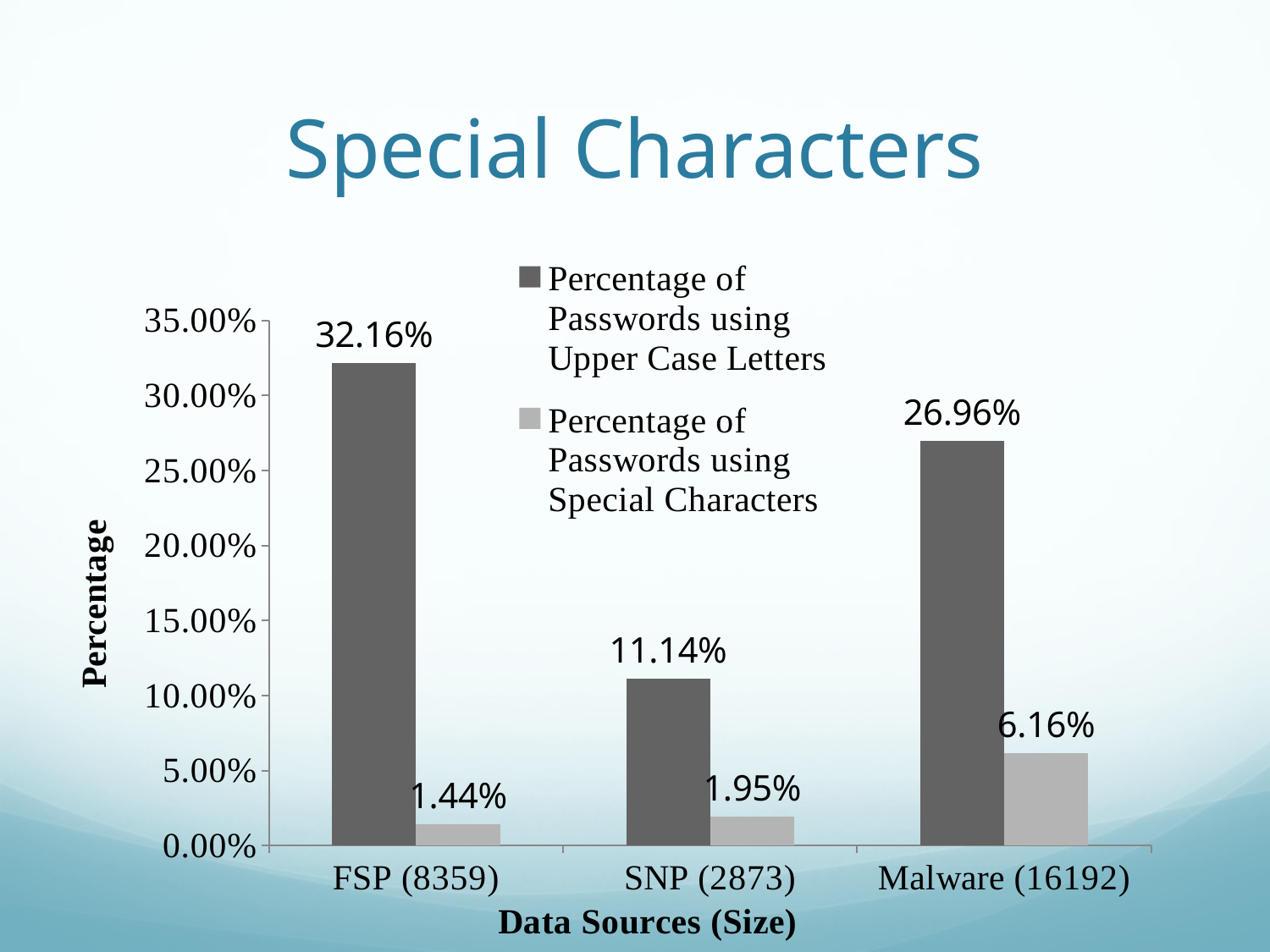
How many series does the legend list? 2 What percentage of passwords in the Malware (16192) data source use special characters? 6.16% Which is larger: the percentage of passwords using special characters for SNP (2873) or for FSP (8359)? SNP (2873) How many data sources are shown on the x axis? 3 Which data source has the lowest percentage of passwords using special characters? FSP (8359) What percentage of passwords in the SNP (2873) data source use upper case letters? 11.14% Is the percentage of passwords using upper case letters for Malware (16192) greater or less than 25.00%? greater Which data source has the highest percentage of passwords using upper case letters? FSP (8359) What percentage of passwords in the FSP (8359) data source use upper case letters? 32.16% What is the difference between the percentage of passwords using upper case letters and the percentage using special characters for Malware (16192)? 20.80% What is the label of the x axis? Data Sources (Size) What kind of chart is shown on the slide? Bar chart